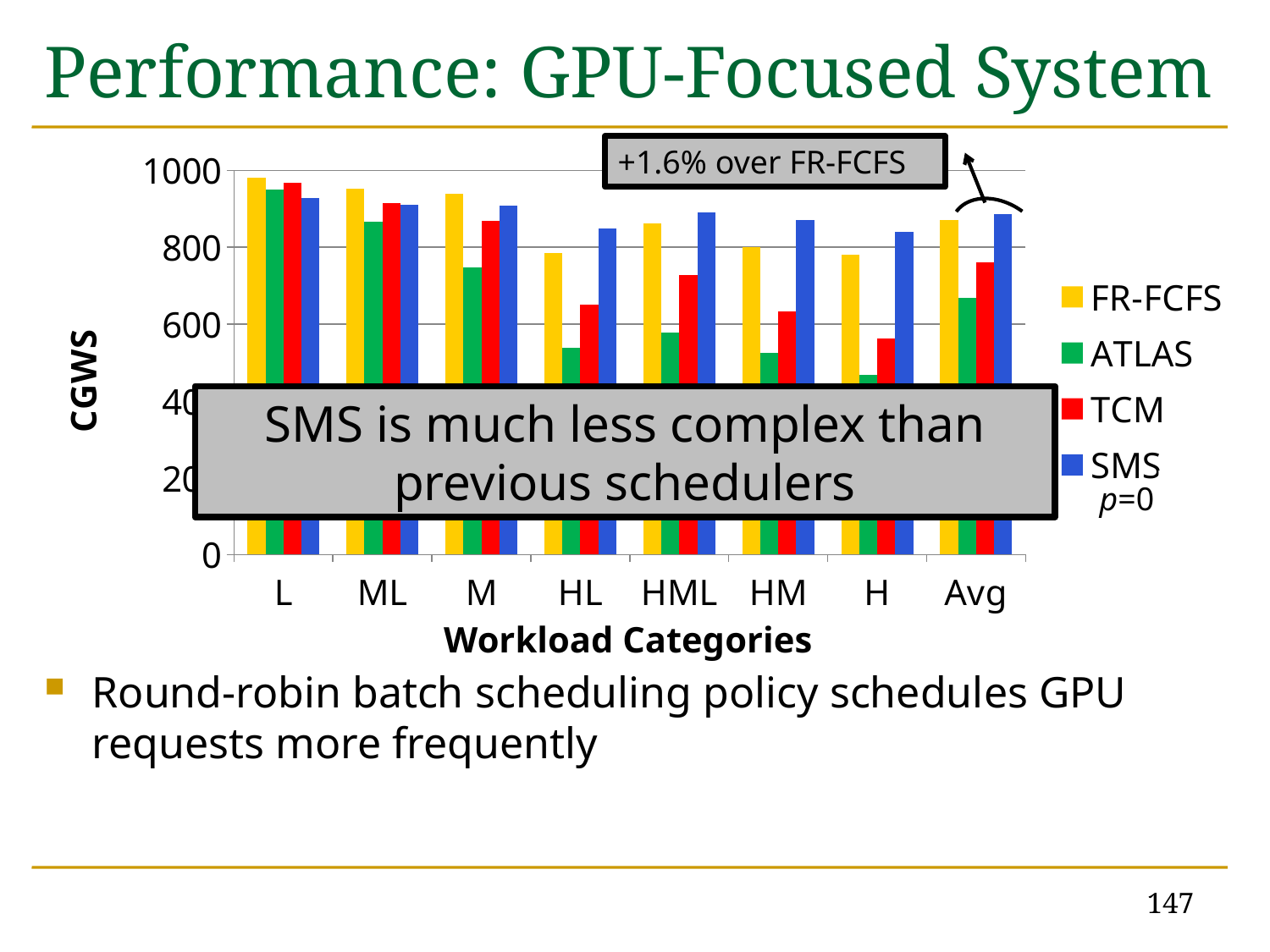
For the HL category, which is larger, the ATLAS value or the TCM value? TCM What is the label on the y axis of the chart? CGWS Do the FR-FCFS values generally rise or fall from L to H along the x axis? fall Which series has the highest value for the HML category? SMS Is the SMS value for HML greater or less than 800? greater What kind of chart is shown on the slide? bar chart How many workload categories are shown on the x axis? 8 Is the TCM value for HL greater or less than 600? greater Which series has the lowest value for the HM category? ATLAS How many series does the legend list? 4 Is the ATLAS value for M greater or less than 800? less